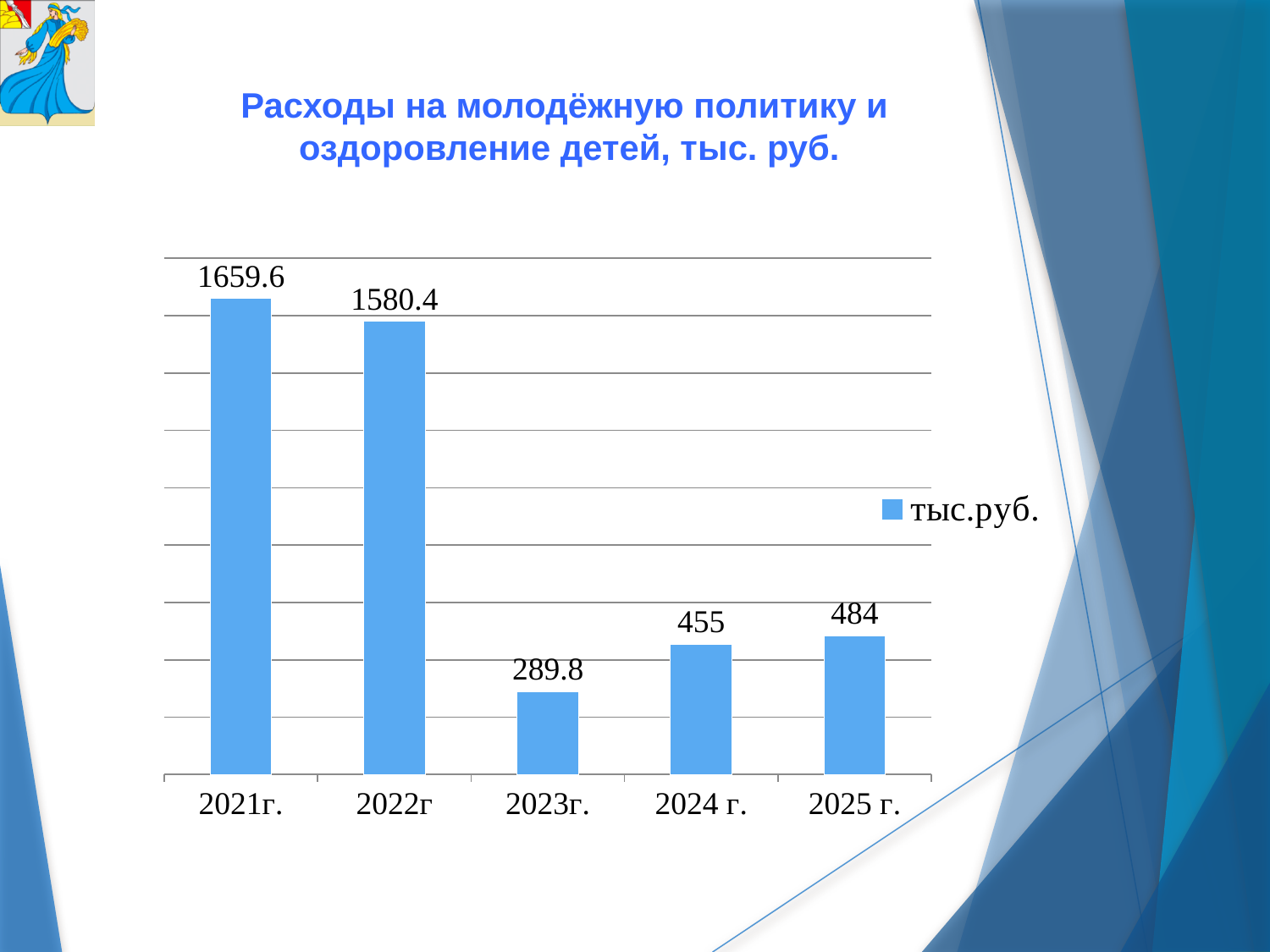
How many years are shown on the x axis? 5 What kind of chart is shown on the slide? bar chart What is the value for 2023г.? 289.8 How many series does the legend list? 1 Which year has the highest value? 2021г. What is the value for 2021г.? 1659.6 What is the value for 2025 г.? 484 What is the difference between the values for 2021г. and 2022г? 79.2 Which is larger, the value for 2024 г. or the value for 2023г.? 2024 г. Which year has the lowest value? 2023г. What is the legend entry of the chart? тыс.руб. What is the difference between the values for 2025 г. and 2024 г.? 29